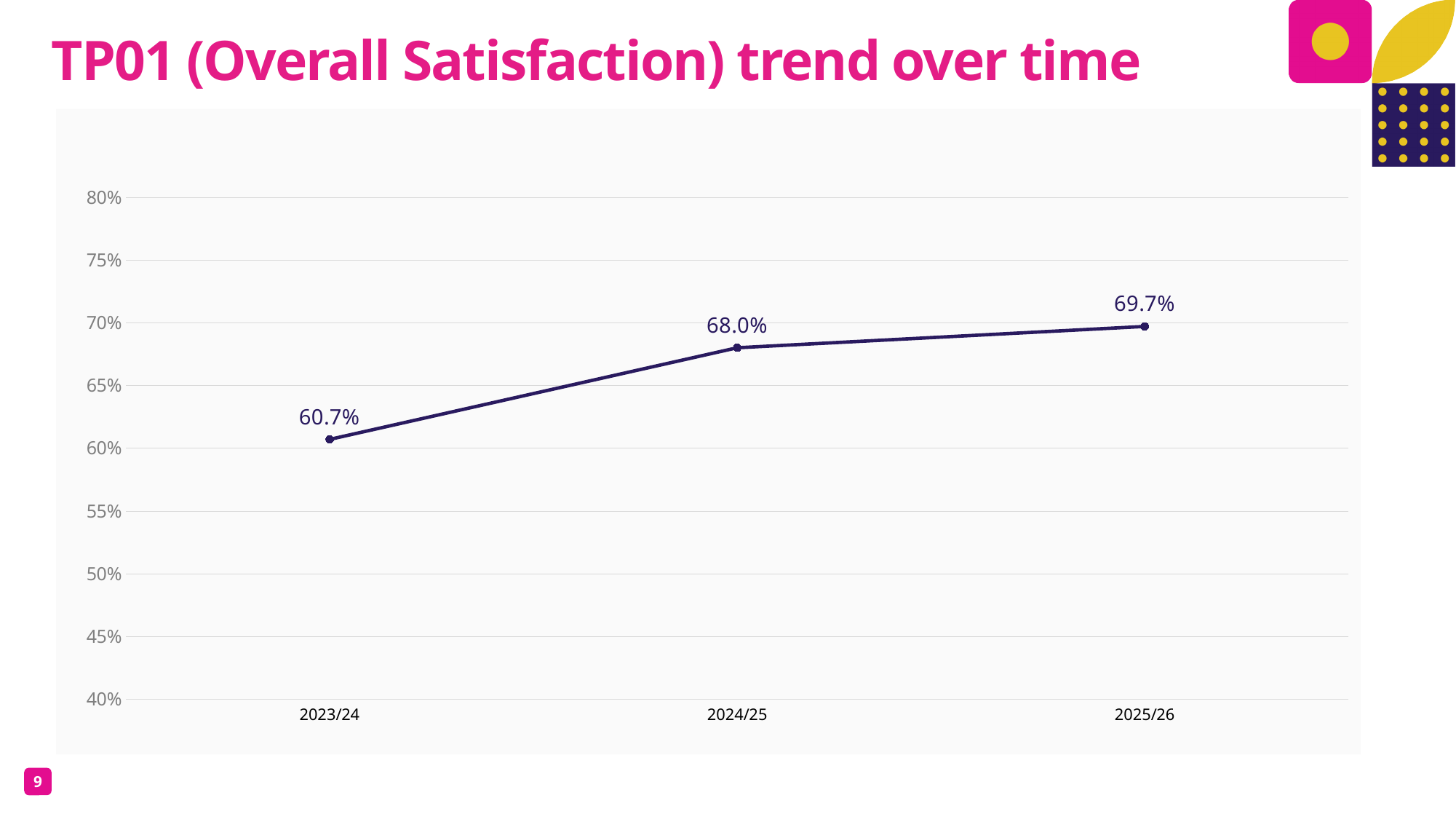
What is the value for 2023/24? 60.7% Which year has the highest value? 2025/26 Which year has the lowest value? 2023/24 Do the values rise or fall from 2023/24 to 2025/26? rise How many data points are plotted on the chart? 3 What kind of chart is shown on the slide? line chart What is the value for 2024/25? 68.0% What is the difference between the values for 2025/26 and 2024/25? 1.7% What is the difference between the values for 2024/25 and 2023/24? 7.3% Is the value for 2024/25 greater or less than 65%? greater What is the value for 2025/26? 69.7% Which is larger, the value for 2023/24 or the value for 2025/26? 2025/26